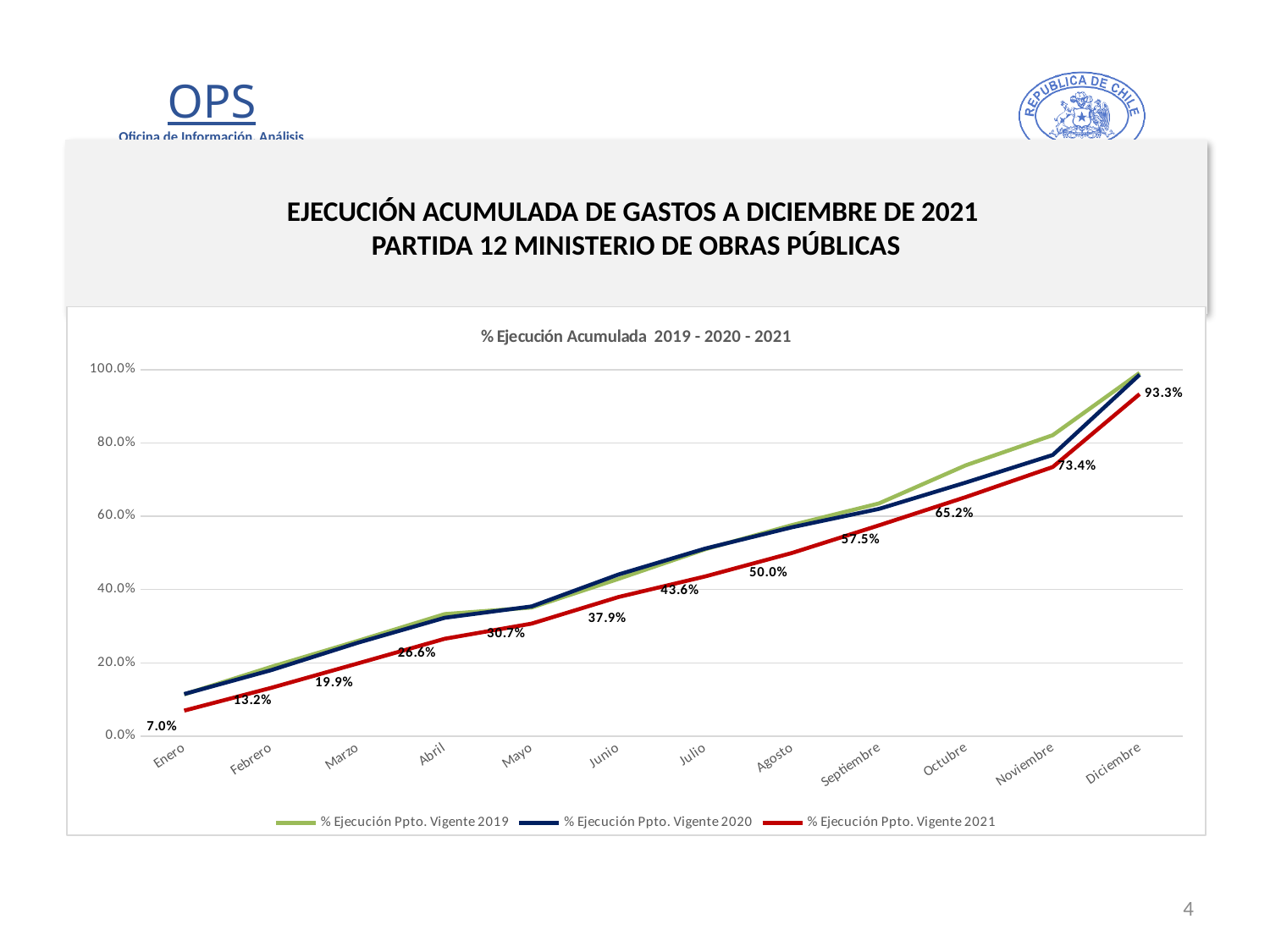
How many series does the legend list? 3 What is the value for % Ejecución Ppto. Vigente 2021 in Enero? 7.0% What is the difference between the % Ejecución Ppto. Vigente 2021 values for Diciembre and Noviembre? 19.9% In which month is the % Ejecución Ppto. Vigente 2021 value lowest? Enero What is the value for % Ejecución Ppto. Vigente 2021 in Noviembre? 73.4% Is the value for % Ejecución Ppto. Vigente 2019 in Diciembre greater or less than 80.0%? greater What is the value for % Ejecución Ppto. Vigente 2021 in Agosto? 50.0% What is the value for % Ejecución Ppto. Vigente 2021 in Diciembre? 93.3% Do the values of the % Ejecución Ppto. Vigente 2021 series rise or fall from Enero to Diciembre? rise What type of chart is shown on the slide? line chart What is the title of the chart? % Ejecución Acumulada 2019 - 2020 - 2021 How many months are shown on the x axis? 12